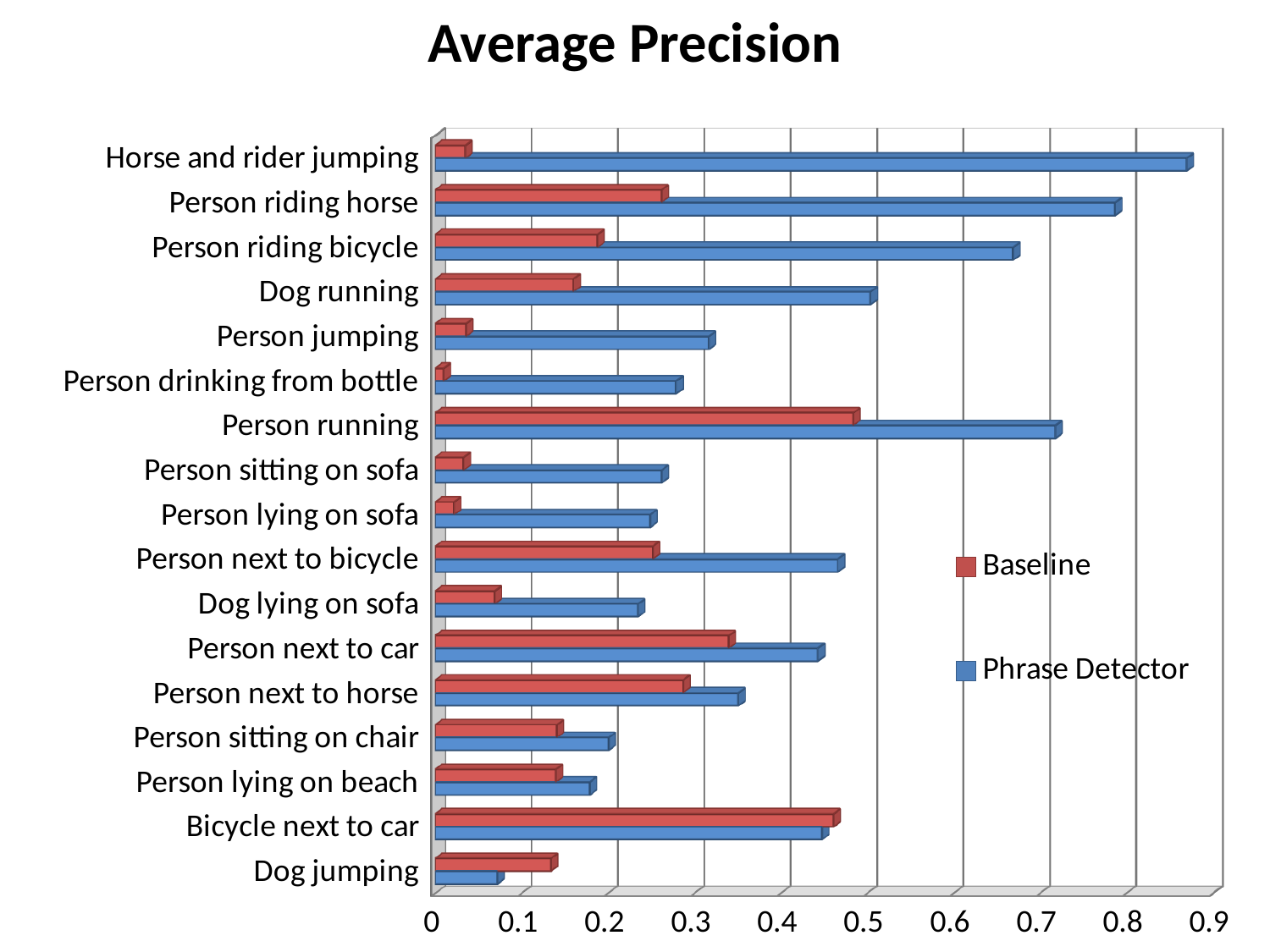
Is the Phrase Detector value for Dog jumping greater or less than 0.1? less How many series does the legend list? 2 Which category has the lowest Phrase Detector value? Dog jumping Which category has the highest Phrase Detector value? Horse and rider jumping For Dog jumping, which series has the larger value, Baseline or Phrase Detector? Baseline What is the title of the chart? Average Precision Is the Baseline value for Person running greater or less than 0.4? greater Is the Phrase Detector value for Person riding horse greater or less than 0.7? greater What kind of chart is shown on the slide? bar chart For Person running, which series has the larger value, Baseline or Phrase Detector? Phrase Detector How many categories are plotted on the chart? 17